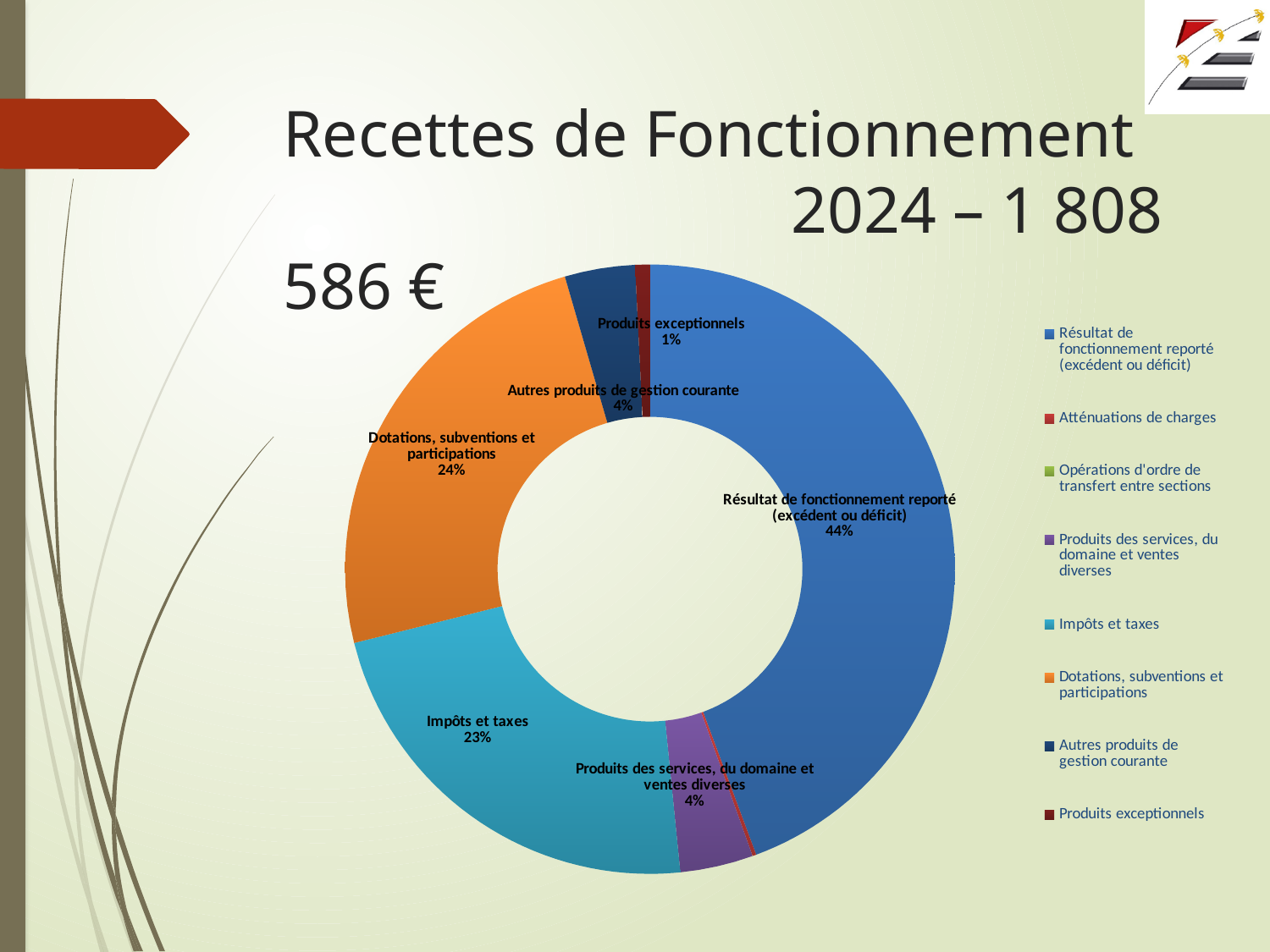
What share of the chart is "Résultat de fonctionnement reporté (excédent ou déficit)"? 44% Which category has the largest share of the chart? Résultat de fonctionnement reporté (excédent ou déficit) What kind of chart is shown on the slide? Doughnut (pie) chart Which labelled category has the smallest share of the chart? Produits exceptionnels Which is larger: the share for "Dotations, subventions et participations" or the share for "Impôts et taxes"? Dotations, subventions et participations What is the difference in percentage points between "Résultat de fonctionnement reporté" and "Dotations, subventions et participations"? 20 percentage points What share of the chart is "Impôts et taxes"? 23% What share of the chart is "Autres produits de gestion courante"? 4% What is the title of the slide containing the chart? Recettes de Fonctionnement 2024 – 1 808 586 € How many entries does the chart legend list? 8